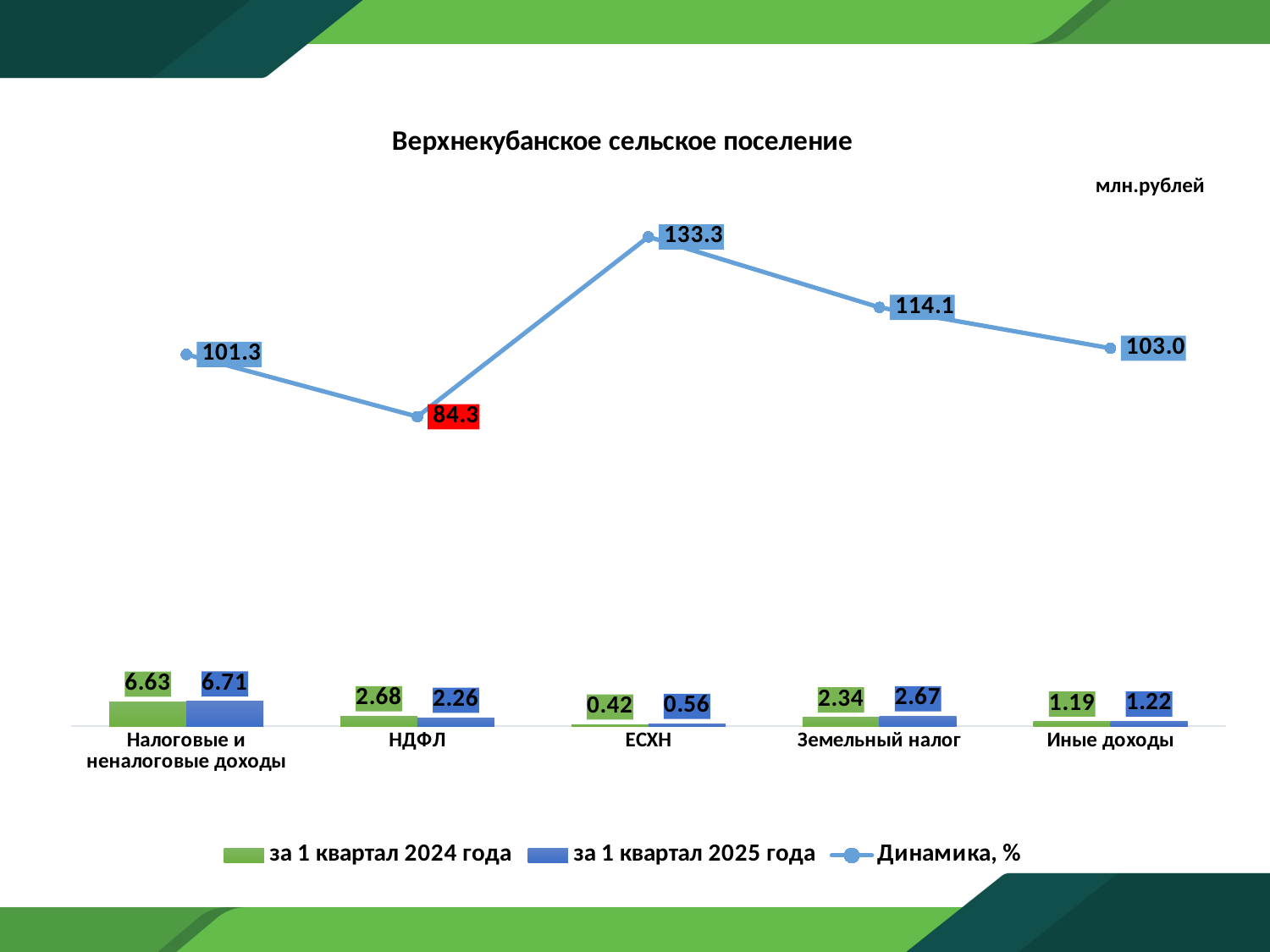
How many series does the legend list? 3 What is the 'Динамика, %' value for Иные доходы? 103.0 For НДФЛ, which is larger: the value for 'за 1 квартал 2024 года' or 'за 1 квартал 2025 года'? за 1 квартал 2024 года Which category has the lowest 'Динамика, %' value? НДФЛ What unit is indicated in the top right of the chart? млн.рублей How many categories are shown on the x axis? 5 What is the value for Земельный налог in the series 'за 1 квартал 2025 года'? 2.67 What is the 'Динамика, %' value for ЕСХН? 133.3 What is the difference between the 'за 1 квартал 2025 года' and 'за 1 квартал 2024 года' values for ЕСХН? 0.14 Which category has the highest value in the series 'за 1 квартал 2025 года'? Налоговые и неналоговые доходы What is the title of the chart? Верхнекубанское сельское поселение What is the value for НДФЛ in the series 'за 1 квартал 2024 года'? 2.68